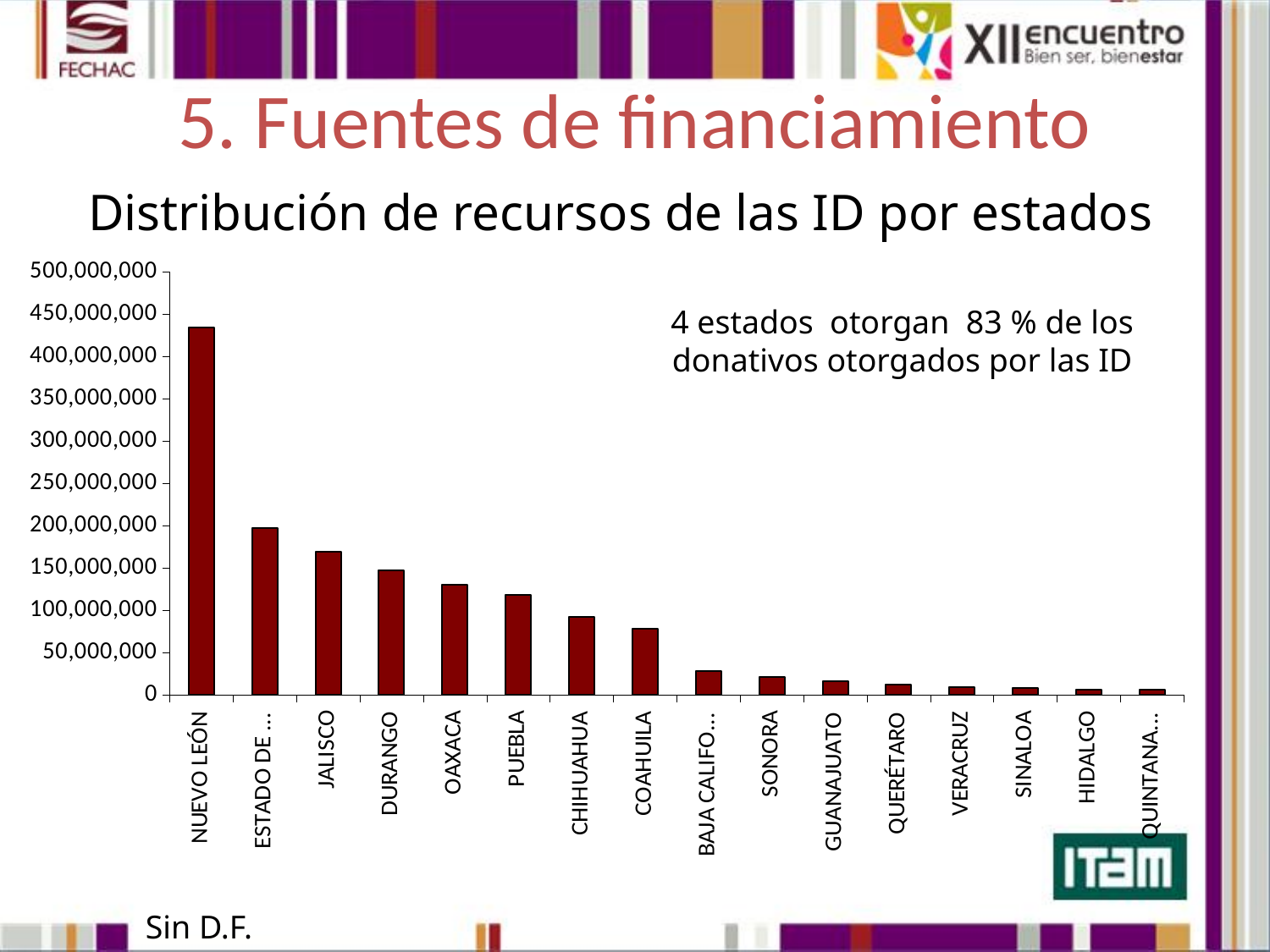
Is the value for CHIHUAHUA greater or less than 100,000,000? less Do the values rise or fall moving from left to right along the x axis? fall Is the value for JALISCO greater or less than 150,000,000? greater Is the value for PUEBLA greater or less than 150,000,000? less Which has a larger value, COAHUILA or SONORA? COAHUILA How many states (categories) are plotted on the chart? 16 What kind of chart is shown on the slide? bar chart Which has a larger value, DURANGO or OAXACA? DURANGO Which state has the highest value on the chart? NUEVO LEÓN What is the title of the chart? Distribución de recursos de las ID por estados